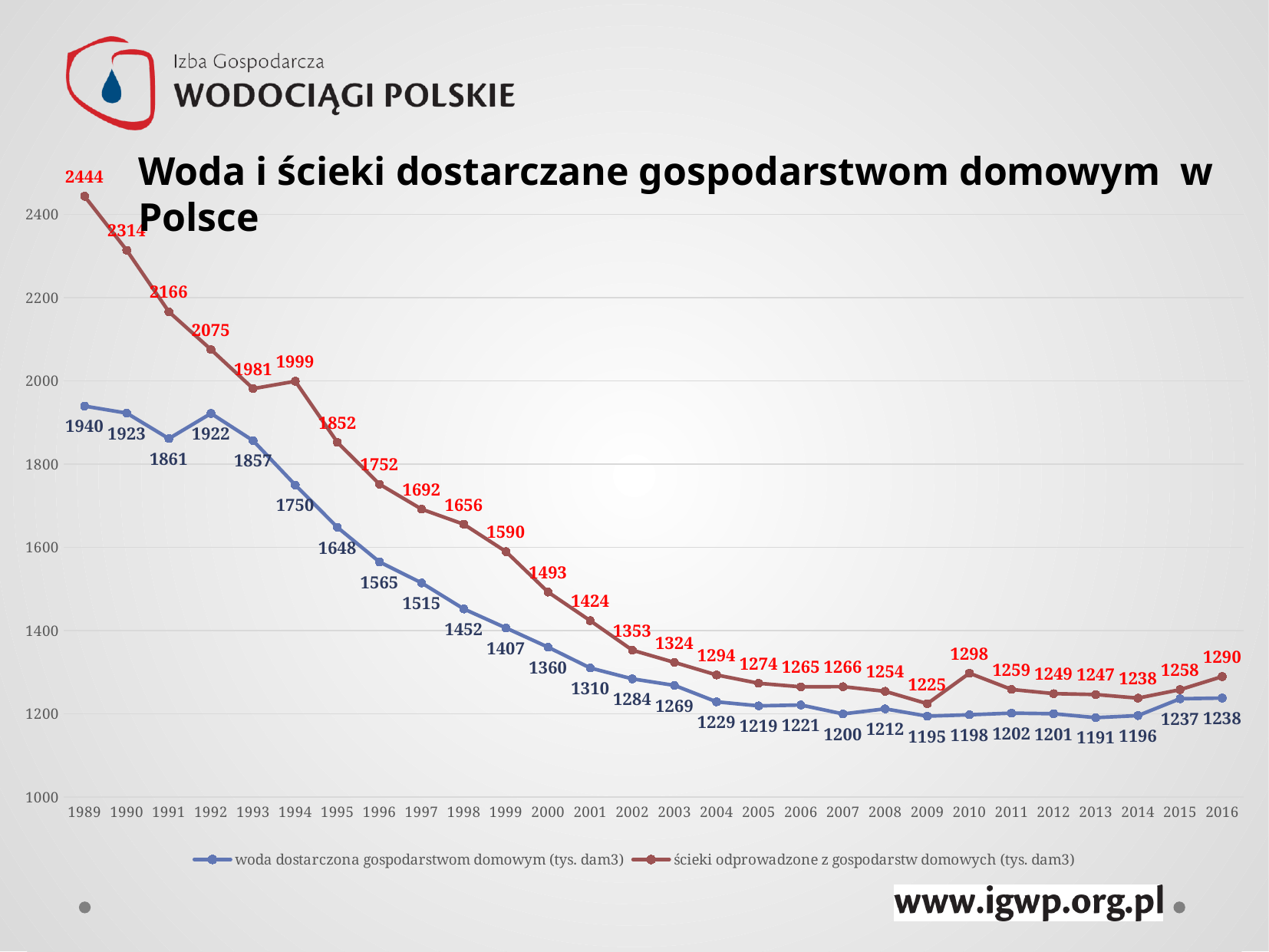
What is the value of 'ścieki odprowadzone z gospodarstw domowych (tys. dam3)' in 2010? 1298 What is the value of 'woda dostarczona gospodarstwom domowym (tys. dam3)' in 1989? 1940 In which year is 'woda dostarczona gospodarstwom domowym (tys. dam3)' lowest? 2013 How many years are plotted along the x axis? 28 What is the overall trend of 'woda dostarczona gospodarstwom domowym (tys. dam3)' from 1989 to 2016? falling What is the title of the chart? Woda i ścieki dostarczane gospodarstwom domowym w Polsce What is the value of 'ścieki odprowadzone z gospodarstw domowych (tys. dam3)' in 2016? 1290 What is the difference between the 'ścieki odprowadzone' value and the 'woda dostarczona' value in 1989? 504 In which year is 'ścieki odprowadzone z gospodarstw domowych (tys. dam3)' highest? 1989 How many series does the legend list? 2 What type of chart is shown on the slide? line chart Which is larger in 2016: 'woda dostarczona gospodarstwom domowym' or 'ścieki odprowadzone z gospodarstw domowych'? ścieki odprowadzone z gospodarstw domowych